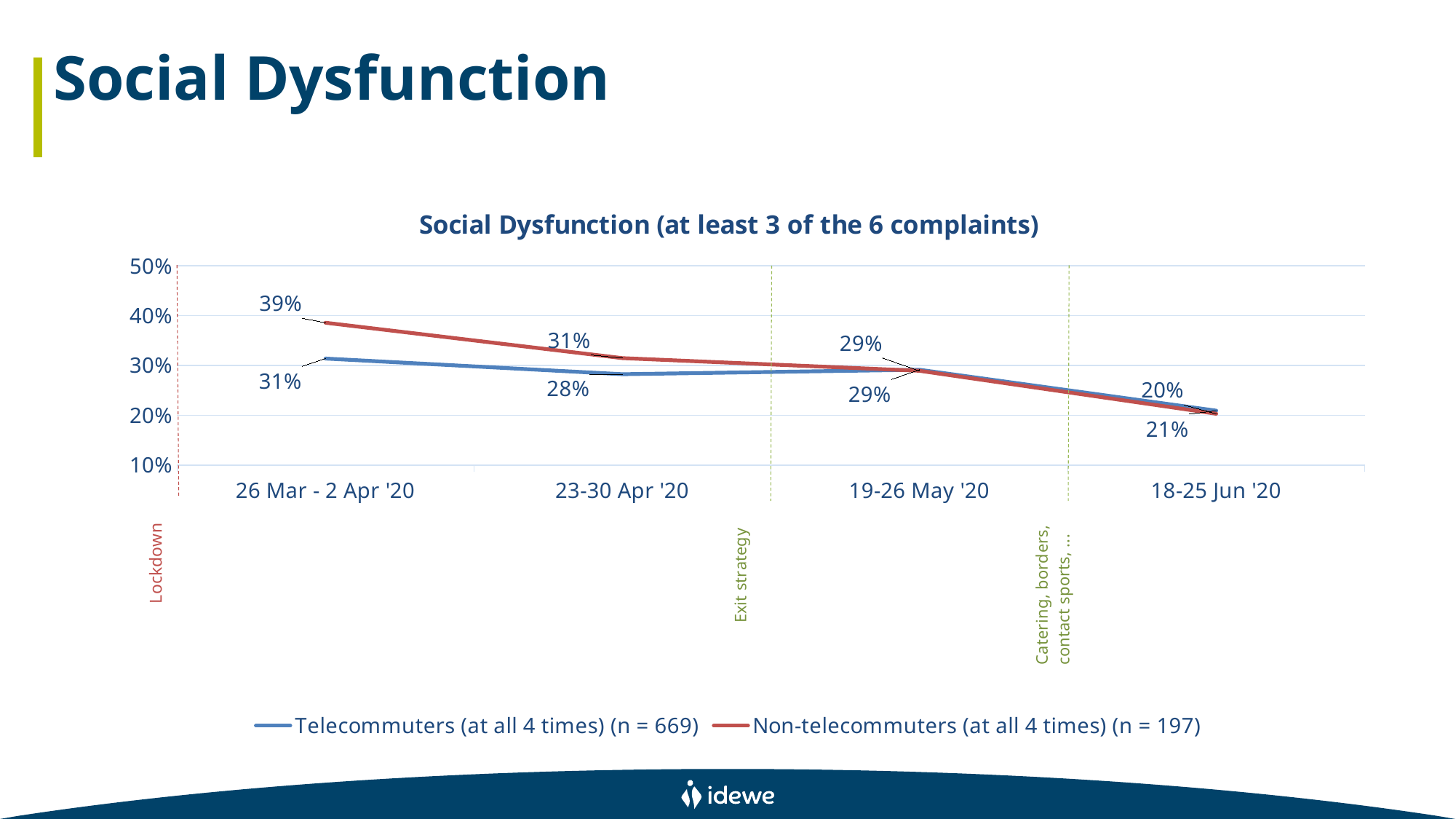
In which period is the Non-telecommuters value highest? 26 Mar - 2 Apr '20 What is the value for Telecommuters in the period 19-26 May '20? 29% How many series does the legend list? 2 What is the value for Non-telecommuters in the period 23-30 Apr '20? 31% What is the difference between Non-telecommuters and Telecommuters in the period 26 Mar - 2 Apr '20? 8 percentage points How many time periods are plotted on the x axis? 4 What is the value for Telecommuters in the period 26 Mar - 2 Apr '20? 31% Does the Non-telecommuters line rise or fall from 26 Mar - 2 Apr '20 to 18-25 Jun '20? fall What kind of chart is shown on the slide? line chart What is the value for Non-telecommuters in the period 26 Mar - 2 Apr '20? 39% According to the legend, what is the sample size (n) for Telecommuters? 669 What is the value for Telecommuters in the period 23-30 Apr '20? 28%